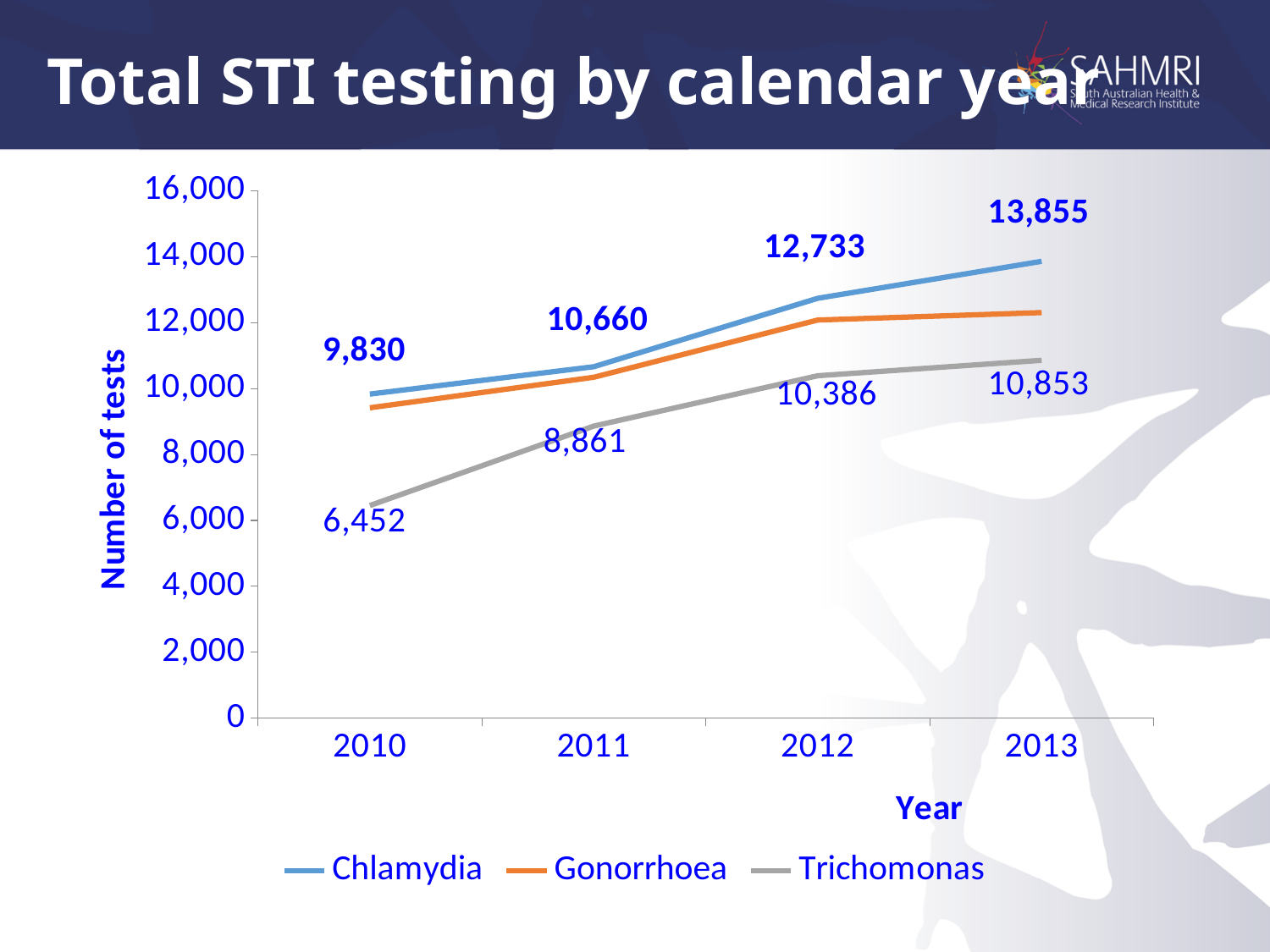
Is the number of Gonorrhoea tests in 2010 greater or less than 10,000? less How many series does the legend list? 3 How many years are shown on the x axis? 4 Which series has more tests in 2010, Chlamydia or Trichomonas? Chlamydia What is the difference between Chlamydia tests in 2013 and 2012? 1,122 What is the number of Trichomonas tests in 2010? 6,452 What type of chart is shown on the slide? Line chart What is the number of Trichomonas tests in 2012? 10,386 In which year is the number of Chlamydia tests highest? 2013 What is the number of Chlamydia tests in 2011? 10,660 What is the number of Chlamydia tests in 2013? 13,855 In which year is the number of Trichomonas tests lowest? 2010